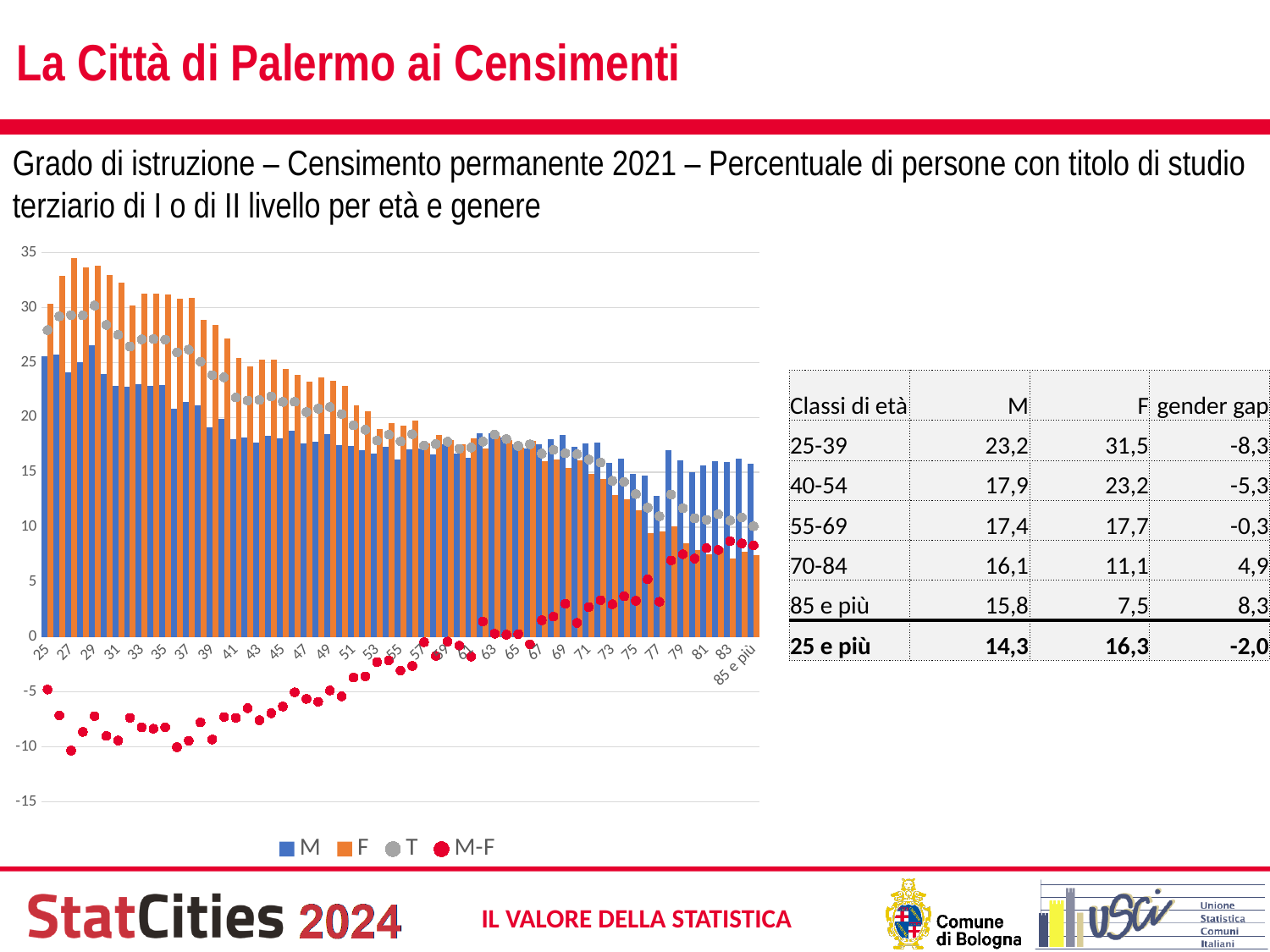
Is the F value for age 27 greater or less than 30? greater Is the T value for age 25 greater or less than 25? greater How many series does the chart legend list? 4 For the '85 e più' category, which series has the larger value, M or F? M At age 25, which series has the larger value, M or F? F Is the M-F value for the '85 e più' category greater or less than 5? greater What colour are the bars for the M series? blue Do the F values generally rise or fall from age 27 to age 77? fall What kind of chart is used to plot the M and F series? bar chart